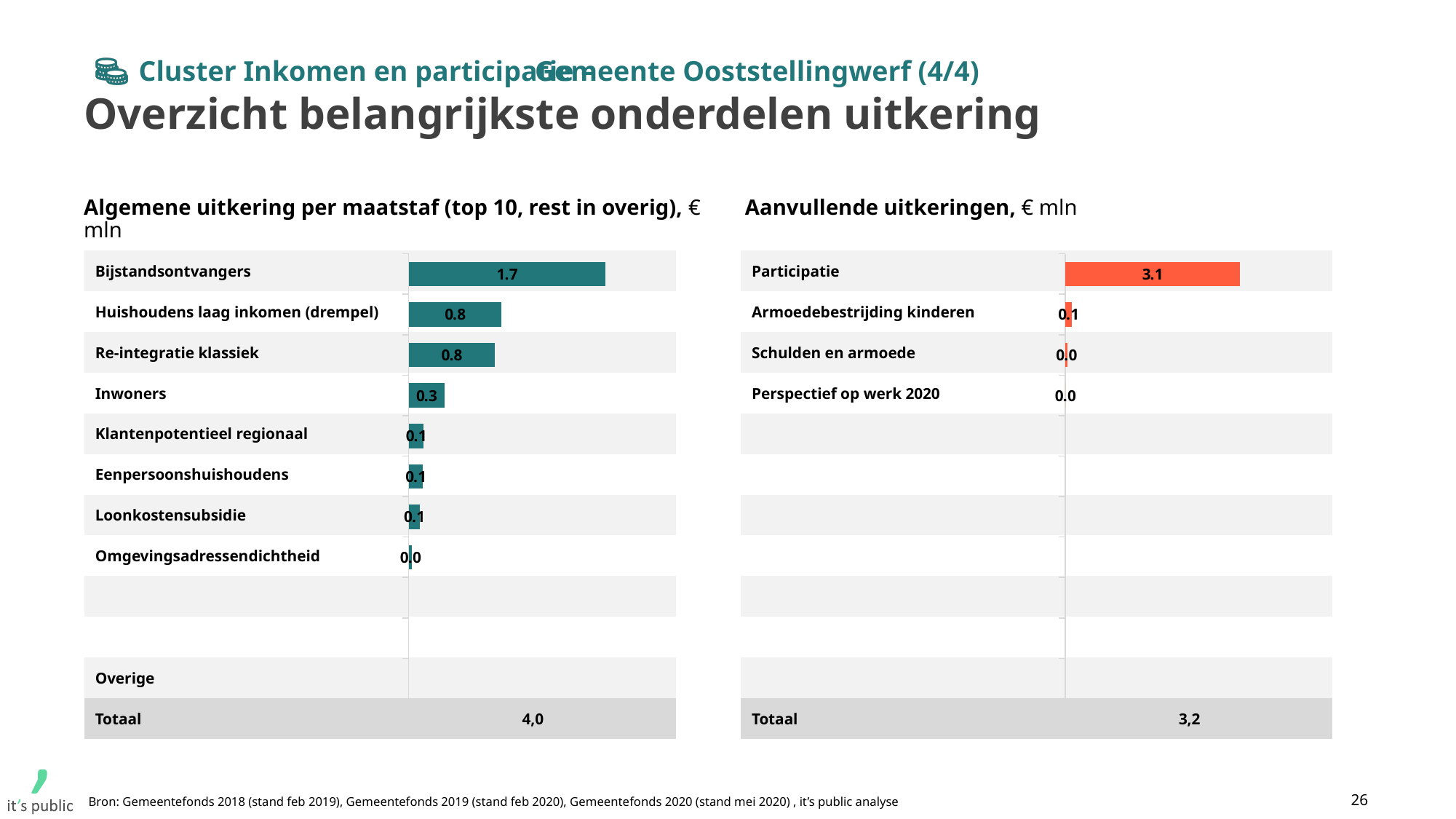
In the 'Aanvullende uitkeringen' chart, what is the value for Armoedebestrijding kinderen? 0.1 In the 'Algemene uitkering per maatstaf' chart, which category has the highest value? Bijstandsontvangers In the 'Aanvullende uitkeringen' chart, what is the value for Participatie? 3.1 In the 'Algemene uitkering per maatstaf' chart, what is the value for Inwoners? 0.3 In the 'Algemene uitkering per maatstaf' chart, what is the value for Bijstandsontvangers? 1.7 In the 'Aanvullende uitkeringen' chart, how many named categories have a plotted value? 4 What is the Totaal shown at the bottom of the 'Algemene uitkering per maatstaf' chart? 4,0 In the 'Aanvullende uitkeringen' chart, what is the difference between Participatie and Armoedebestrijding kinderen? 3.0 In the 'Algemene uitkering per maatstaf' chart, which is larger: Re-integratie klassiek or Inwoners? Re-integratie klassiek In the 'Algemene uitkering per maatstaf' chart, what is the difference between Bijstandsontvangers and Huishoudens laag inkomen (drempel)? 0.9 In the 'Aanvullende uitkeringen' chart, which category has the highest value? Participatie What type of chart is the 'Aanvullende uitkeringen' chart? Bar chart